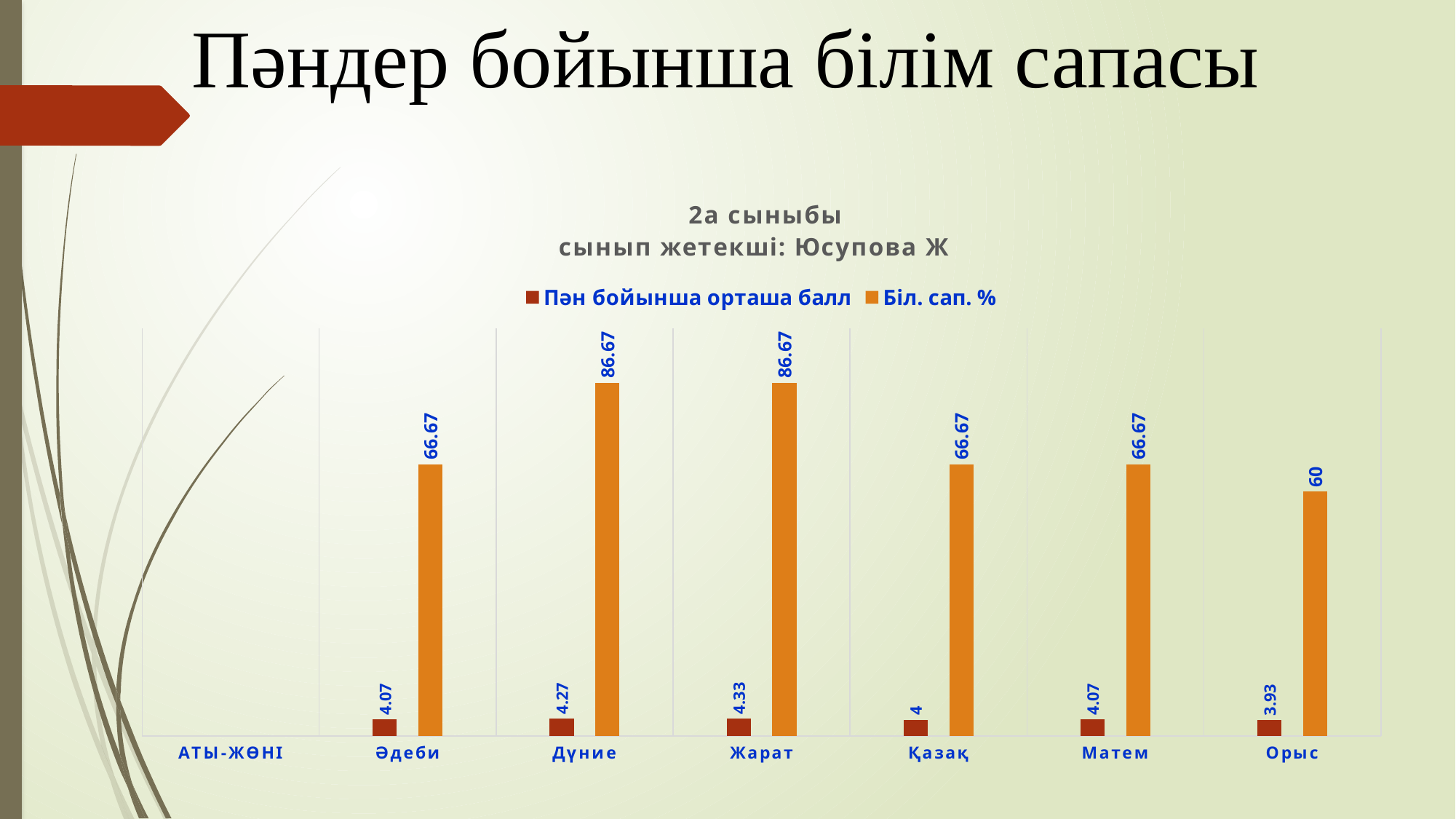
Which subject has the highest value of "Пән бойынша орташа балл"? Жарат Which is larger, the "Біл. сап. %" value for Дүние or for Матем? Дүние What kind of chart is shown on the slide? Bar chart Which subject has the lowest value of "Пән бойынша орташа балл"? Орыс What colour are the bars for the "Біл. сап. %" series? Orange What is the value of "Пән бойынша орташа балл" for Жарат? 4.33 What is the value of "Пән бойынша орташа балл" for Қазақ? 4 What is the difference between the "Біл. сап. %" values for Жарат and Орыс? 26.67 What is the value of "Біл. сап. %" for Дүние? 86.67 What is the value of "Біл. сап. %" for Орыс? 60 How many series does the legend list? 2 Which subject has the lowest value of "Біл. сап. %"? Орыс